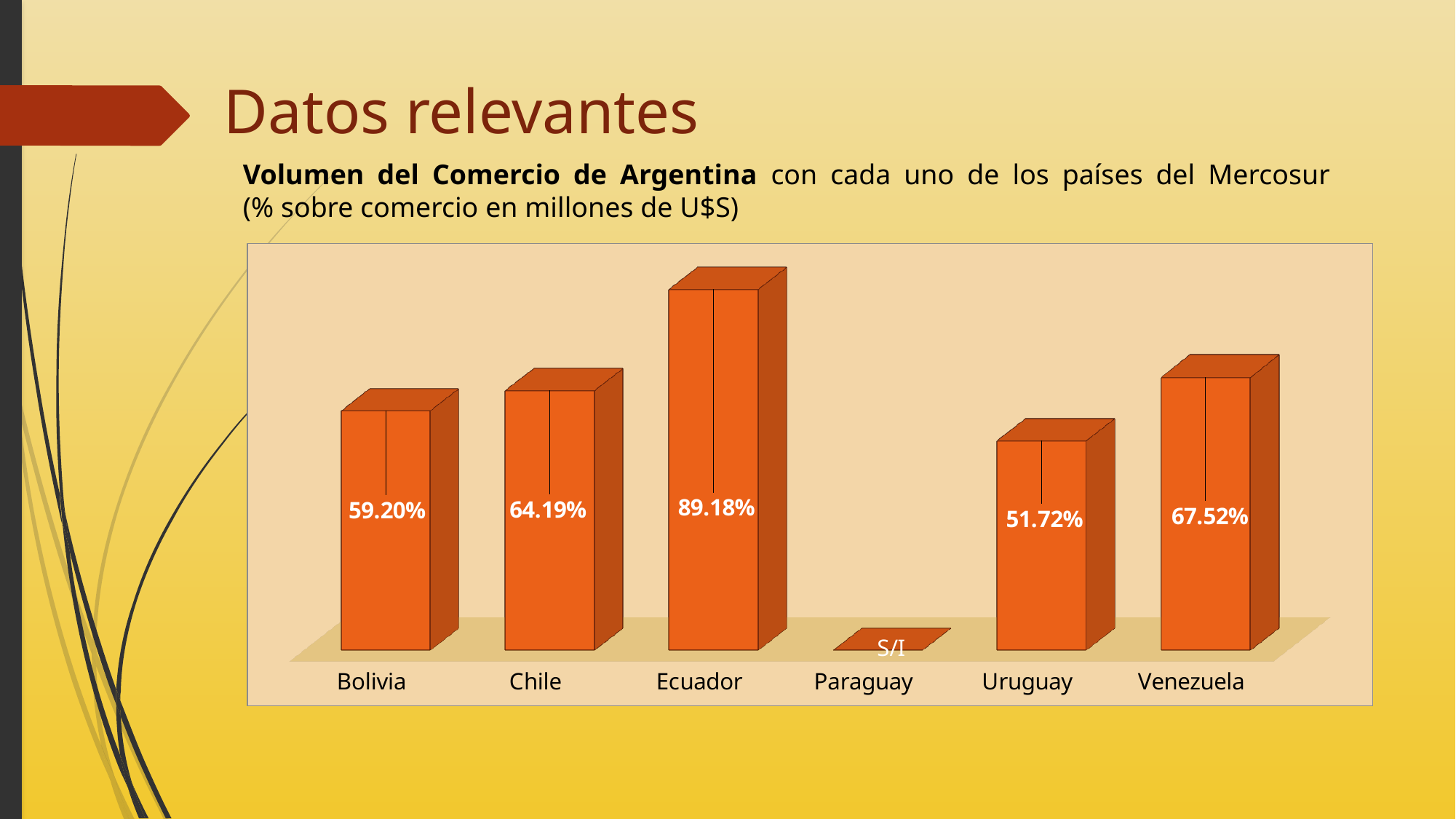
What kind of chart is this? Bar chart What is the value for Uruguay? 51.72% What is the difference between the values for Ecuador and Chile? 24.99% What is the value for Bolivia? 59.20% How many countries are shown on the x axis? 6 Which country has the highest value? Ecuador What is the value for Ecuador? 89.18% Which country with a printed percentage has the lowest value? Uruguay Which is larger, the value for Chile or the value for Venezuela? Venezuela What label is shown for Paraguay? S/I What is the difference between the values for Venezuela and Uruguay? 15.80% What colour are the bars? Orange